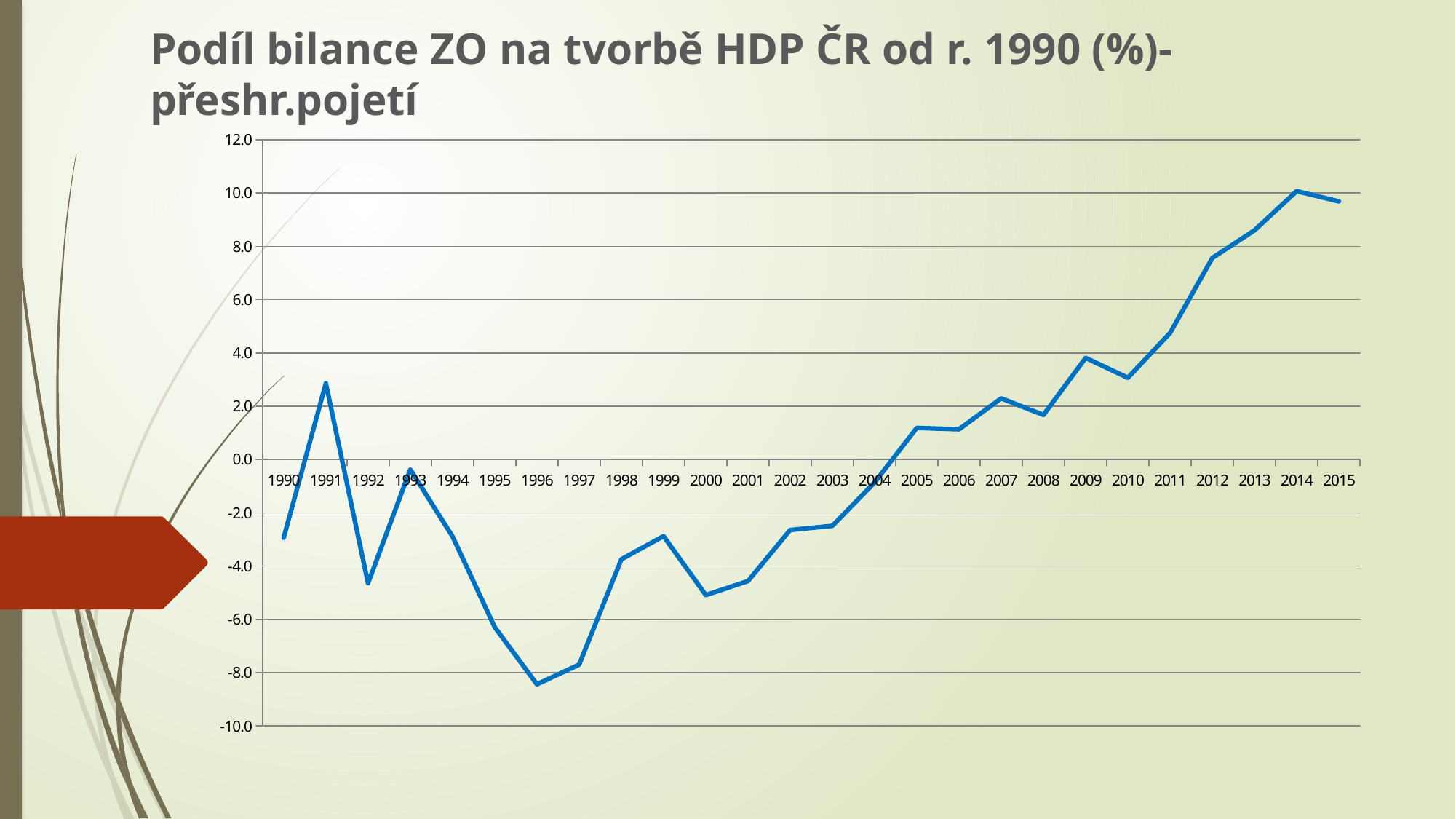
Is the value for 2000 greater or less than -4.0? less Which year has the lowest value? 1996 Is the value for 1996 greater or less than -8.0? less Which year has the higher value, 1998 or 2000? 1998 How many years are plotted on the x axis? 26 What is the title of the chart? Podíl bilance ZO na tvorbě HDP ČR od r. 1990 (%)- přeshr.pojetí What kind of chart is shown on the slide? line chart Is the value for 2014 greater or less than 8.0? greater Which year has the higher value, 1991 or 1993? 1991 Which year has the highest value? 2014 Do the values rise or fall from 2010 to 2014? rise